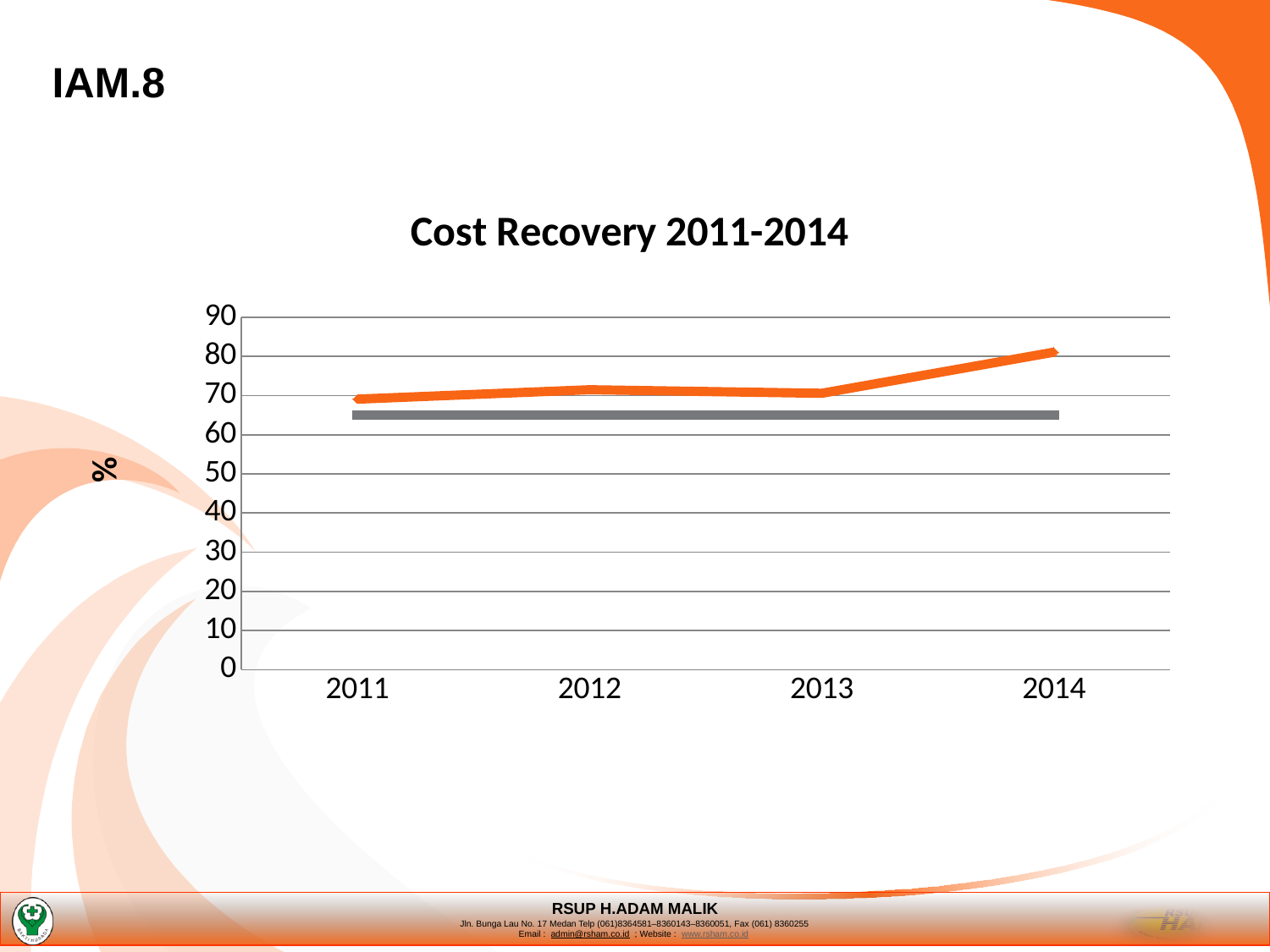
Which year has the highest value on the orange line? 2014 What kind of chart is shown on the slide? line chart What label is shown on the vertical axis of the chart? % Is the gray line's value greater or less than 60? greater What is the title of the chart? Cost Recovery 2011-2014 Is the orange line's value for 2012 greater or less than 80? less How many years are shown on the x axis of the chart? 4 Does the orange line rise or fall overall from 2011 to 2014? rise Is the orange line's value for 2011 greater or less than 60? greater Which is larger on the orange line, the value for 2014 or the value for 2011? 2014